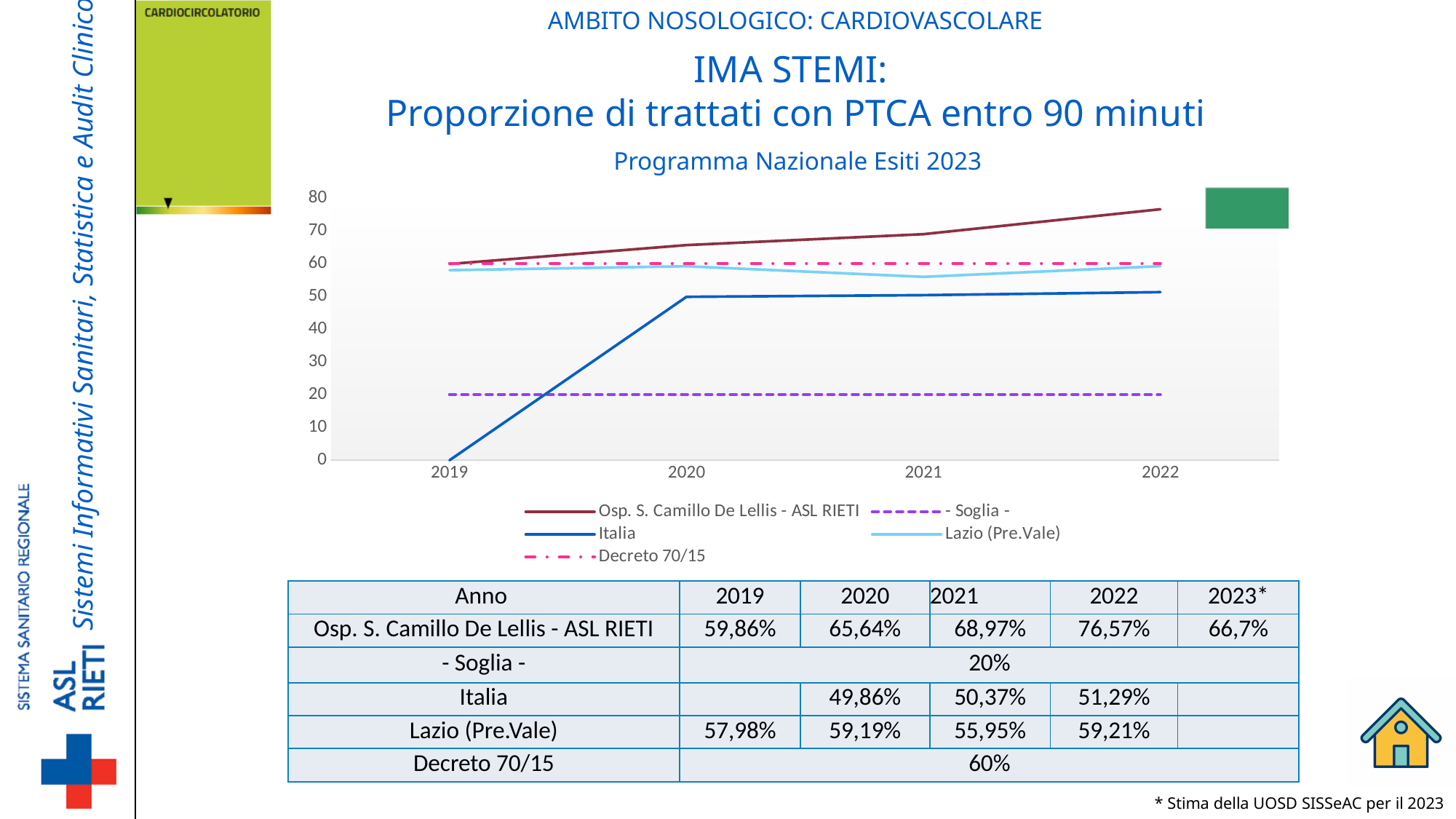
In which year does Osp. S. Camillo De Lellis - ASL RIETI reach its highest value on the chart? 2022 What kind of chart is shown on the slide? line chart How many series does the chart legend list? 5 In 2020, which is higher: Osp. S. Camillo De Lellis - ASL RIETI or Lazio (Pre.Vale)? Osp. S. Camillo De Lellis - ASL RIETI Does the Osp. S. Camillo De Lellis - ASL RIETI line rise or fall from 2019 to 2022? rises What is the difference between the Osp. S. Camillo De Lellis - ASL RIETI values for 2022 and 2021? 7,60% Is the value for Italia in 2022 greater or less than 60? less How many years are shown on the x axis of the chart? 4 In which year is the Lazio (Pre.Vale) value lowest? 2021 What is the value for Osp. S. Camillo De Lellis - ASL RIETI in 2022? 76,57% What is the value for Lazio (Pre.Vale) in 2021? 55,95% What is the value for Italia in 2020? 49,86%